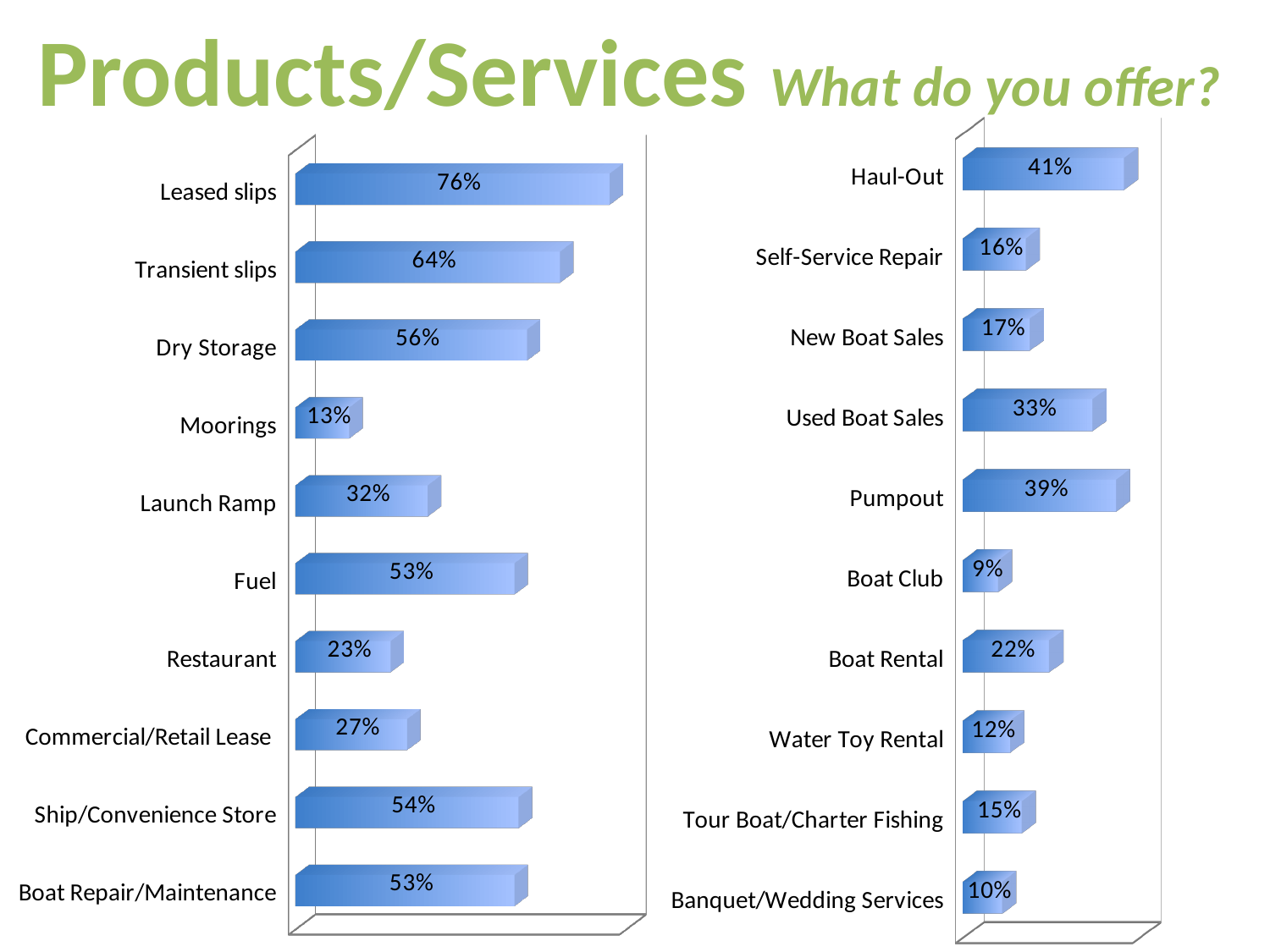
How many categories are shown in the right chart? 10 What kind of chart is the left chart? Bar chart In the left chart, what is the value for Leased slips? 76% In the left chart, what is the difference between Transient slips and Dry Storage? 8% In the left chart, which category has the lowest value? Moorings In the right chart, which category has the highest value? Haul-Out In the right chart, which category has the lowest value? Boat Club In the left chart, which category has the highest value? Leased slips In the right chart, what is the difference between Haul-Out and Self-Service Repair? 25% In the right chart, which is larger, Used Boat Sales or Boat Rental? Used Boat Sales In the right chart, what is the value for Pumpout? 39% How many categories are shown in the left chart? 10